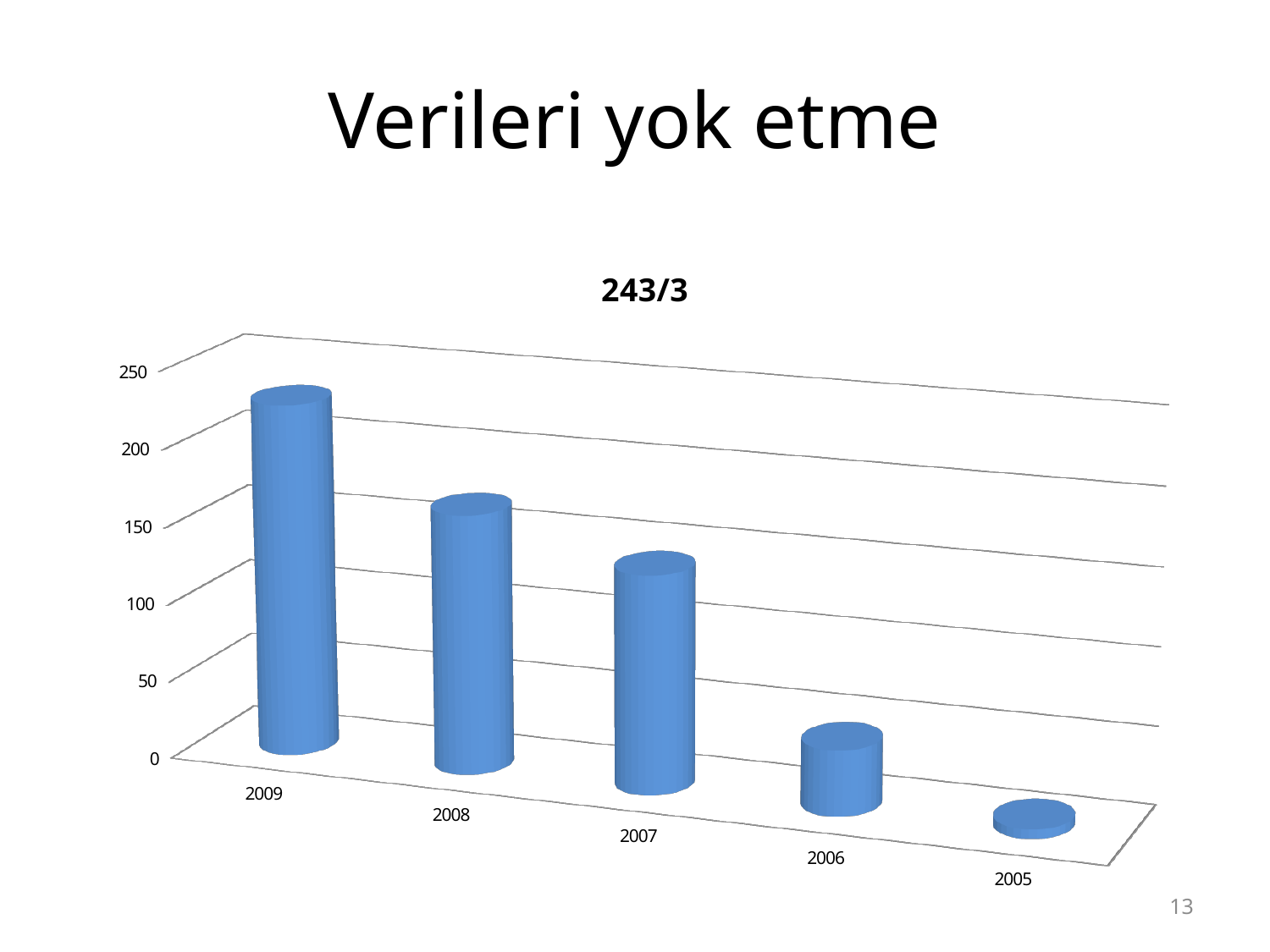
Do the values rise or fall moving from left to right along the x axis (from 2009 to 2005)? fall How many years are shown on the x axis of the chart? 5 What is the title of the chart? 243/3 Is the value for 2006 greater or less than 100? less What kind of chart is shown on the slide? bar chart Is the value for 2005 greater or less than 50? less Which has a larger value, 2007 or 2005? 2007 Which year has the highest value in the chart? 2009 Which has a larger value, 2008 or 2006? 2008 Is the value for 2009 greater or less than 200? greater Which year has the lowest value in the chart? 2005